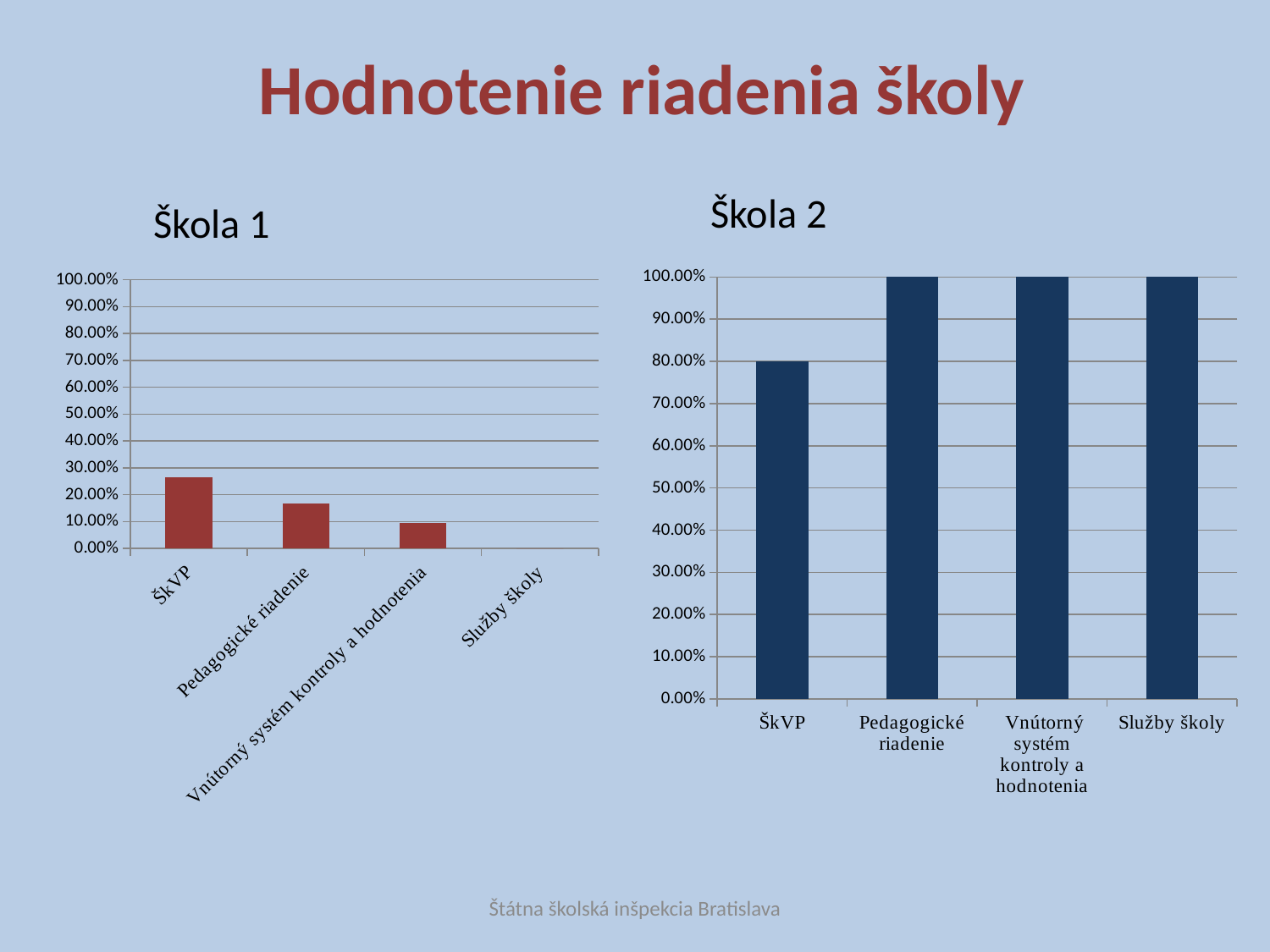
In the Škola 1 chart, is the value for ŠkVP greater or less than 20.00%? greater How many categories are shown on the Škola 2 chart? 4 In the Škola 2 chart, is the value for Pedagogické riadenie greater or less than 90.00%? greater In the Škola 2 chart, what is the value for Služby školy? 100.00% In the Škola 1 chart, is the value for Vnútorný systém kontroly a hodnotenia greater or less than 20.00%? less In the Škola 1 chart, which category has the lowest value? Služby školy In the Škola 2 chart, what is the value for ŠkVP? 80.00% In the Škola 2 chart, which category has the lowest value? ŠkVP What kind of chart is the Škola 1 chart? bar chart In the Škola 1 chart, which is larger: the value for ŠkVP or the value for Pedagogické riadenie? ŠkVP What is the title of the slide containing the two charts? Hodnotenie riadenia školy In the Škola 1 chart, which category has the highest value? ŠkVP